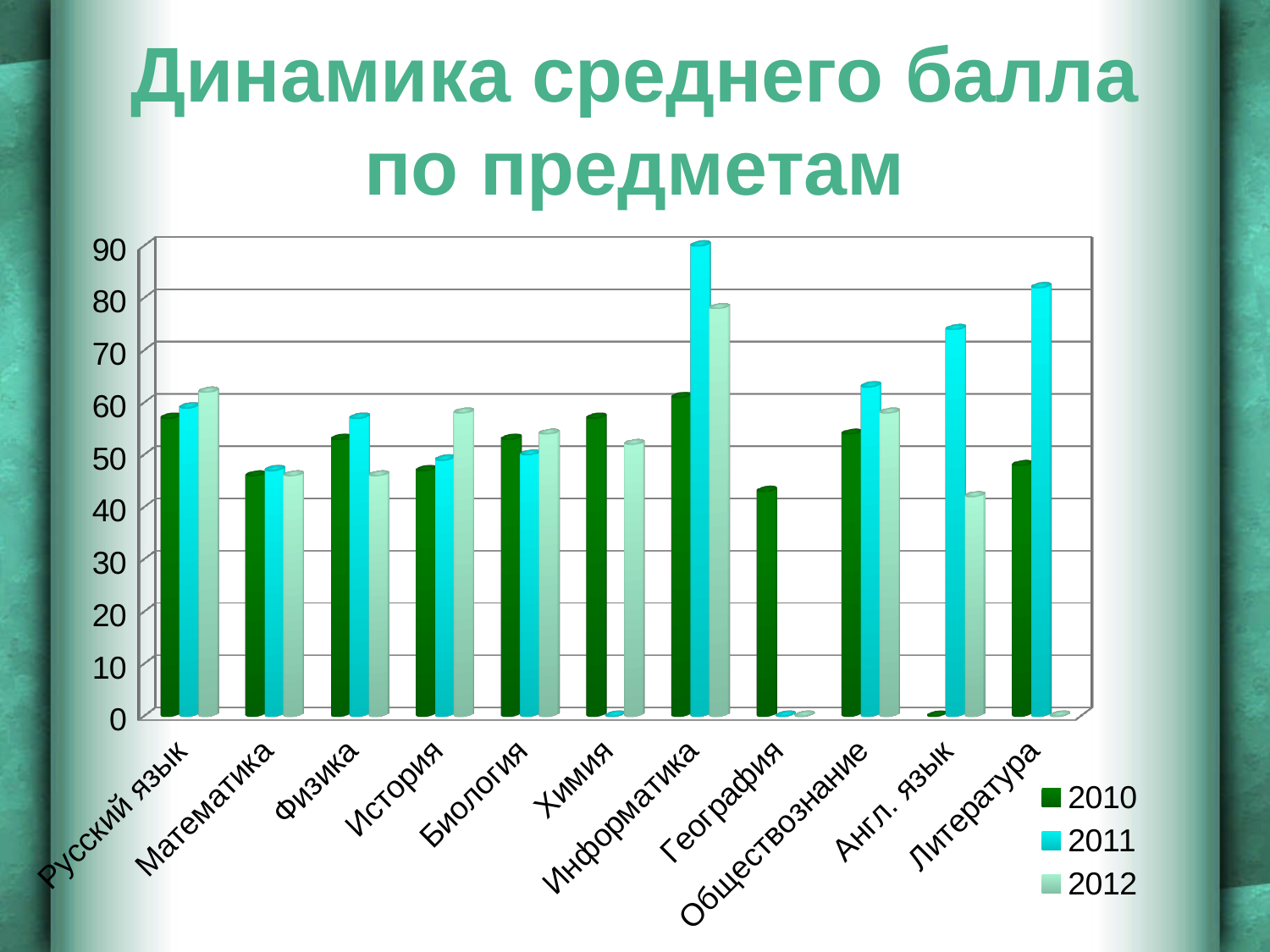
Is the 2011 value for Англ. язык greater or less than 70? greater How many series does the legend list? 3 For Физика, which year has the larger value, 2011 or 2012? 2011 Is the 2011 value for Информатика greater or less than 80? greater What kind of chart is shown on the slide? bar chart Is the 2010 value for География greater or less than 50? less For Литература, which year has the larger value, 2010 or 2011? 2011 Which subject has the highest bar for 2011? Информатика How many subjects are shown on the x axis? 11 What are the entries in the chart legend? 2010, 2011, 2012 Which has the larger 2012 value, Информатика or Русский язык? Информатика